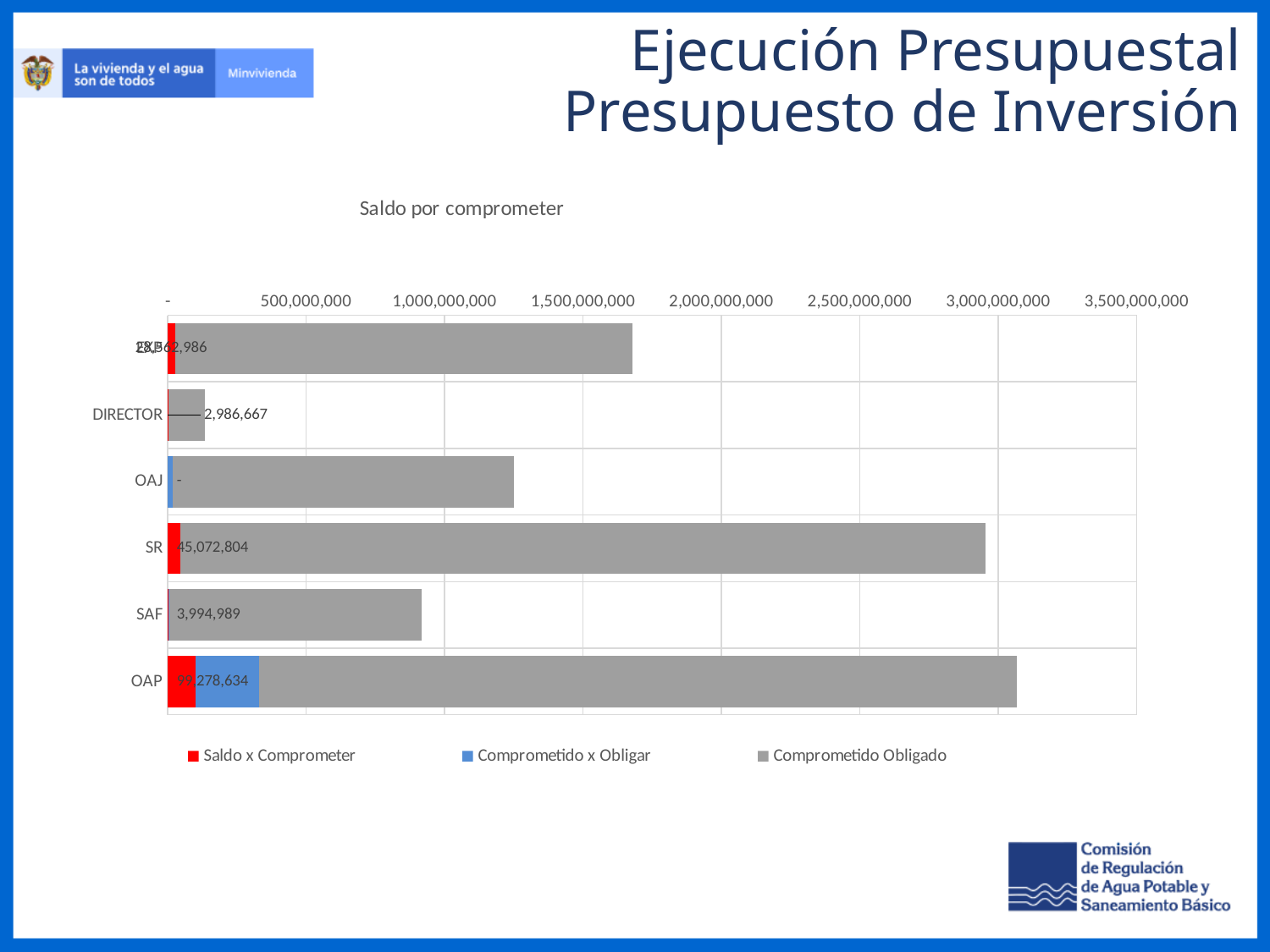
What data label is shown for OAJ? - Is the total bar length for SAF greater or less than 1,000,000,000? less How many categories are plotted on the y axis? 6 What is the difference between the labelled Saldo x Comprometer values for SR and SAF? 41,077,815 What colour represents Saldo x Comprometer in the legend? red What kind of chart is shown on the slide? bar chart What is the Saldo x Comprometer value labelled for DIRECTOR? 2,986,667 What is the Saldo x Comprometer value labelled for SR? 45,072,804 What is the Saldo x Comprometer value labelled for SAF? 3,994,989 Which category has the shortest total bar? DIRECTOR How many series does the legend list? 3 Which has the larger labelled Saldo x Comprometer value, SR or SAF? SR